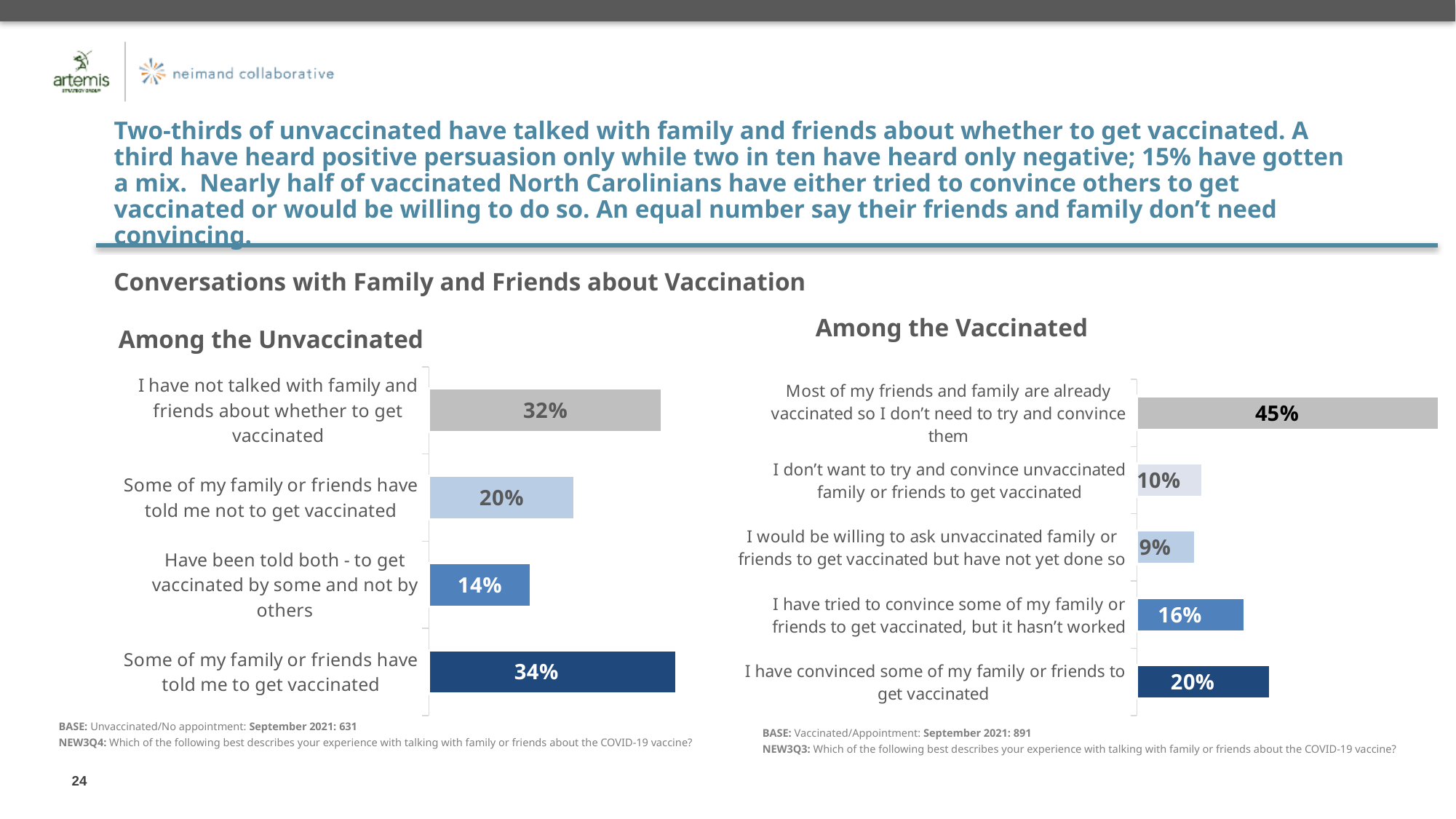
In the 'Among the Unvaccinated' chart, which category has the lowest value? Have been told both - to get vaccinated by some and not by others In the 'Among the Vaccinated' chart, which category has the highest value? Most of my friends and family are already vaccinated so I don't need to try and convince them In the 'Among the Unvaccinated' chart, what percentage have not talked with family and friends about whether to get vaccinated? 32% In the 'Among the Vaccinated' chart, what percentage say most of their friends and family are already vaccinated so they don't need to try and convince them? 45% In the 'Among the Unvaccinated' chart, what is the difference between 'Some of my family or friends have told me to get vaccinated' and 'Some of my family or friends have told me not to get vaccinated'? 14% In the 'Among the Vaccinated' chart, which category has the lowest value? I would be willing to ask unvaccinated family or friends to get vaccinated but have not yet done so How many categories are shown in the 'Among the Unvaccinated' chart? 4 In the 'Among the Unvaccinated' chart, what percentage say some of their family or friends have told them to get vaccinated? 34% What type of chart is the 'Among the Unvaccinated' chart? Bar chart In the 'Among the Vaccinated' chart, what percentage have tried to convince some of their family or friends to get vaccinated, but it hasn't worked? 16% How many categories are shown in the 'Among the Vaccinated' chart? 5 In the 'Among the Vaccinated' chart, what is the difference between 'I have convinced some of my family or friends to get vaccinated' and 'I don't want to try and convince unvaccinated family or friends to get vaccinated'? 10%